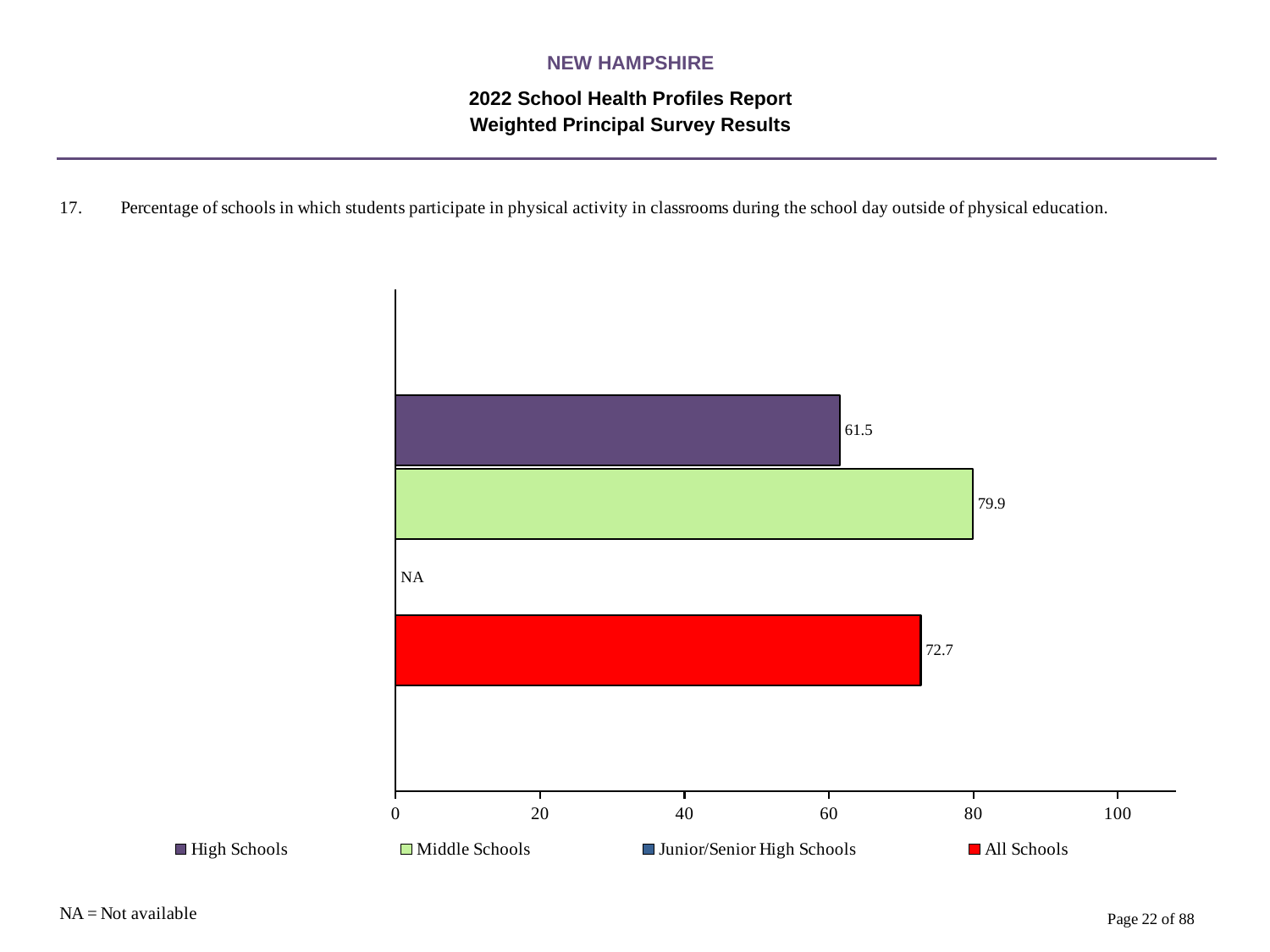
What is the value for High Schools? 61.5 Which is larger, the value for All Schools or the value for Middle Schools? Middle Schools Which series with a plotted value has the lowest value? High Schools Which series has the highest value? Middle Schools What kind of chart is shown on the slide? bar chart What is the difference between the Middle Schools value and the High Schools value? 18.4 How many series does the legend list? 4 Is the value for High Schools greater or less than 60? greater What is the value for All Schools? 72.7 What is shown for Junior/Senior High Schools? NA What is the value for Middle Schools? 79.9 What is the difference between the All Schools value and the High Schools value? 11.2